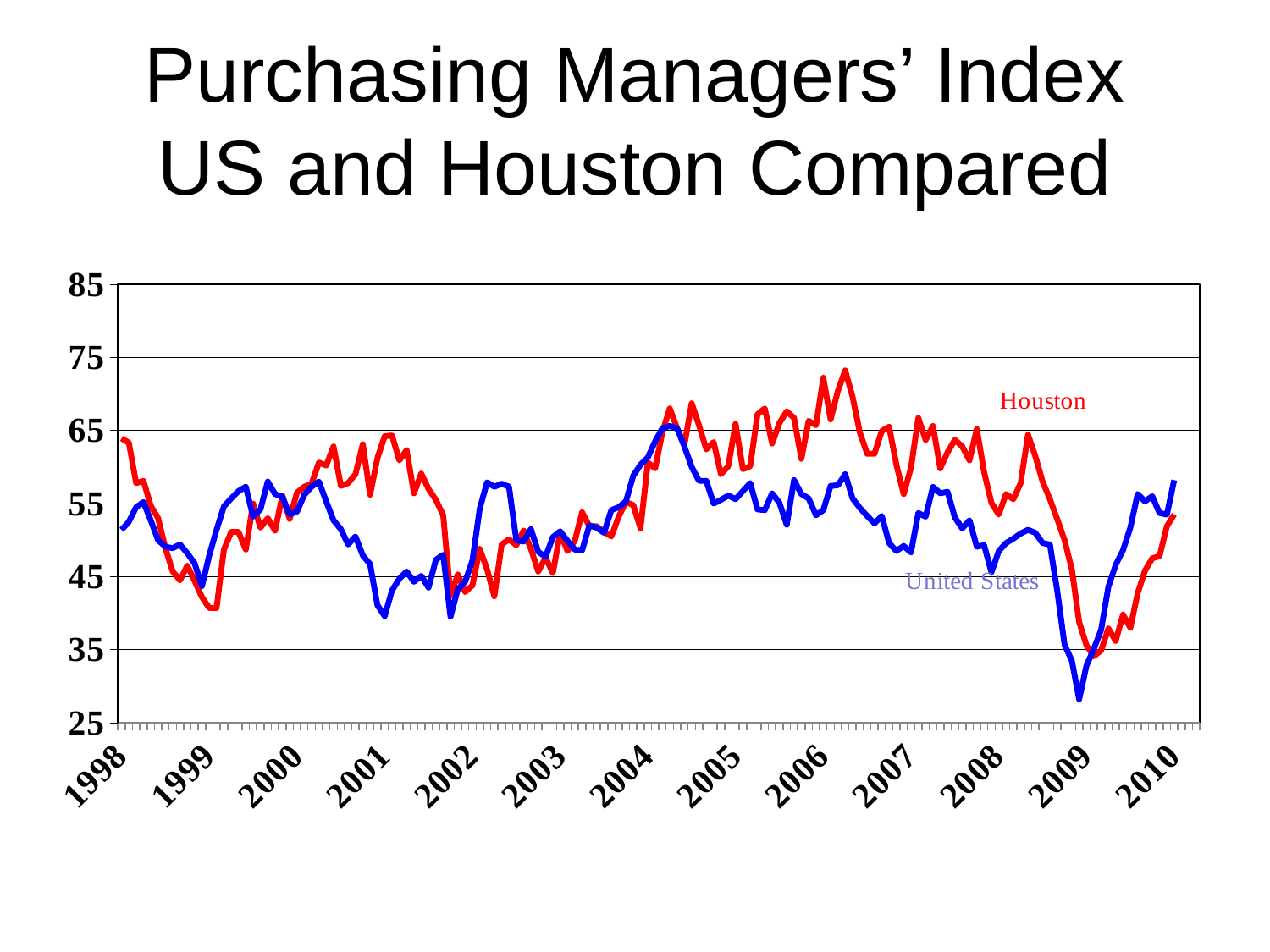
Is the peak value of the Houston series in 2006 greater or less than 65? greater What kind of chart is shown on the slide? Line chart Is the lowest value of the United States series in 2009 greater or less than 35? less What is the title of the chart on the slide? Purchasing Managers' Index US and Houston Compared Which series fell to the lower value in 2009, Houston or United States? United States Is the lowest value of the United States series in early 2001 greater or less than 45? less How many series are plotted on the chart? 2 How many year labels are shown on the x axis? 13 Which colour is used for the Houston series? Red Which series reached the higher peak during 2006, Houston or United States? Houston Do the values of both series rise or fall between 2008 and early 2009? Fall